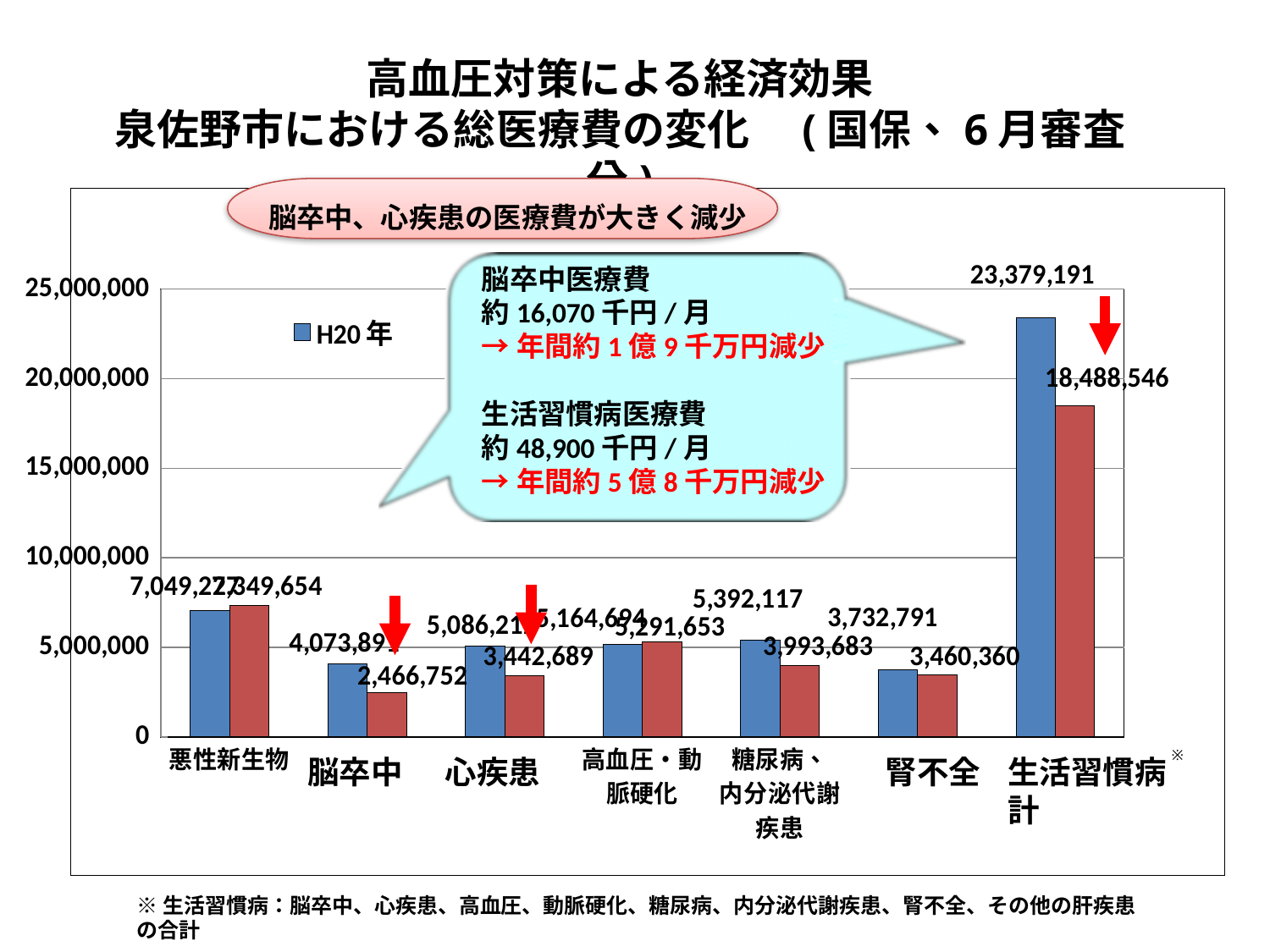
What is the value of the red bar for 脳卒中? 2,466,752 What is the value of the red bar for 生活習慣病計? 18,488,546 What is the H20年 value for 糖尿病、内分泌代謝疾患? 5,392,117 What is the value of the red bar for 心疾患? 3,442,689 Which category has the highest H20年 value? 生活習慣病計 What is the H20年 value for 腎不全? 3,732,791 For 腎不全, what is the difference between the H20年 value and the red bar value? 272,431 For 糖尿病、内分泌代謝疾患, which is larger: the H20年 bar or the red bar? H20年 bar For 生活習慣病計, how much larger is the H20年 value than the red bar value? 4,890,645 How many categories are shown on the x axis? 7 What is the H20年 value for 生活習慣病計? 23,379,191 What kind of chart is shown on the slide? Bar chart